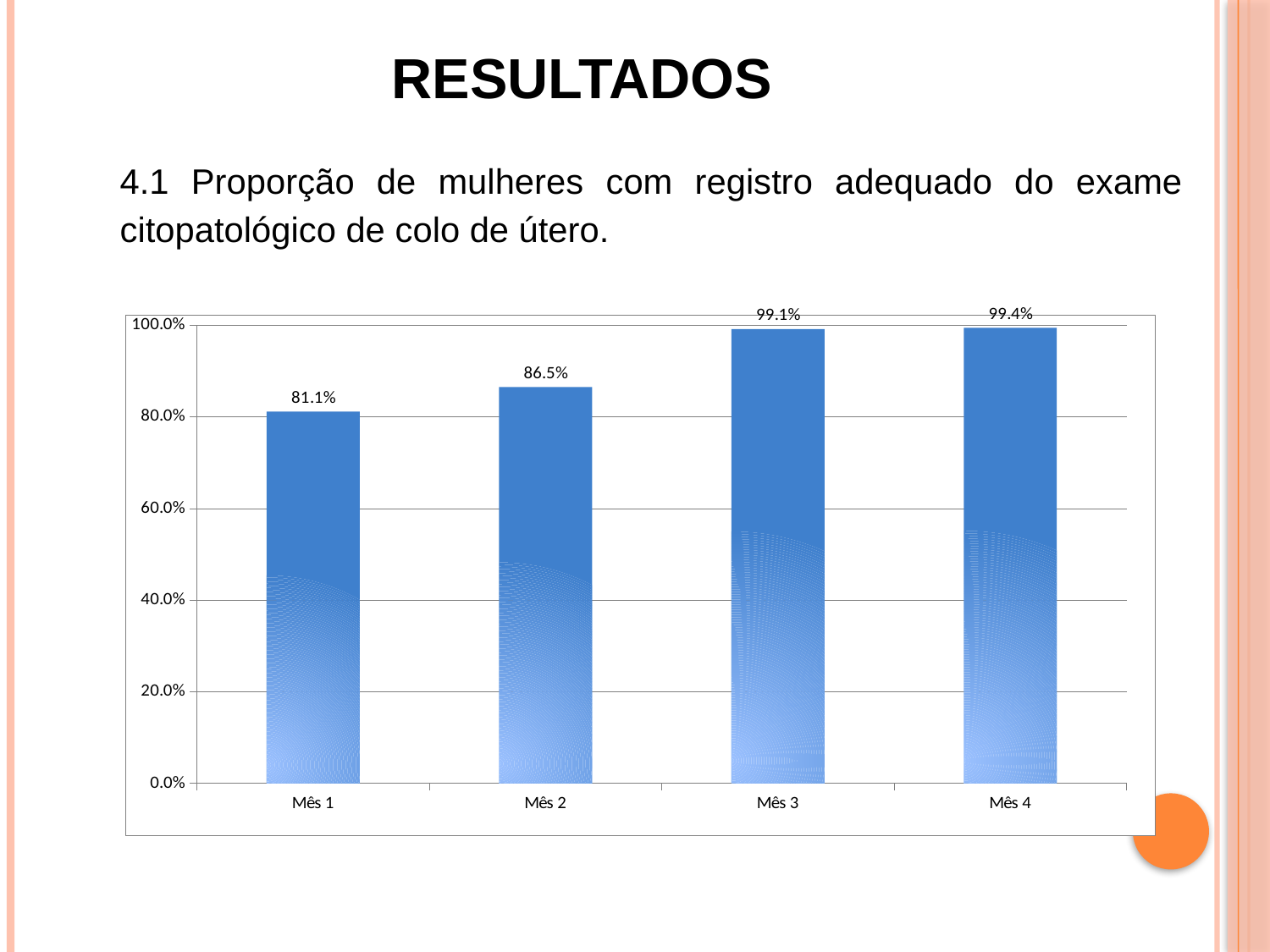
What is the difference between the values for Mês 2 and Mês 1? 5.4% Which month has the lowest value? Mês 1 What is the value for Mês 1? 81.1% What is the difference between the values for Mês 3 and Mês 2? 12.6% How many months are shown on the x axis? 4 What kind of chart is shown on the slide? bar chart Which is larger, the value for Mês 2 or the value for Mês 3? Mês 3 What is the value for Mês 4? 99.4% What is the value for Mês 3? 99.1% Is the value for Mês 1 greater or less than 80.0%? greater Do the values rise or fall from Mês 1 to Mês 4? rise What is the value for Mês 2? 86.5%